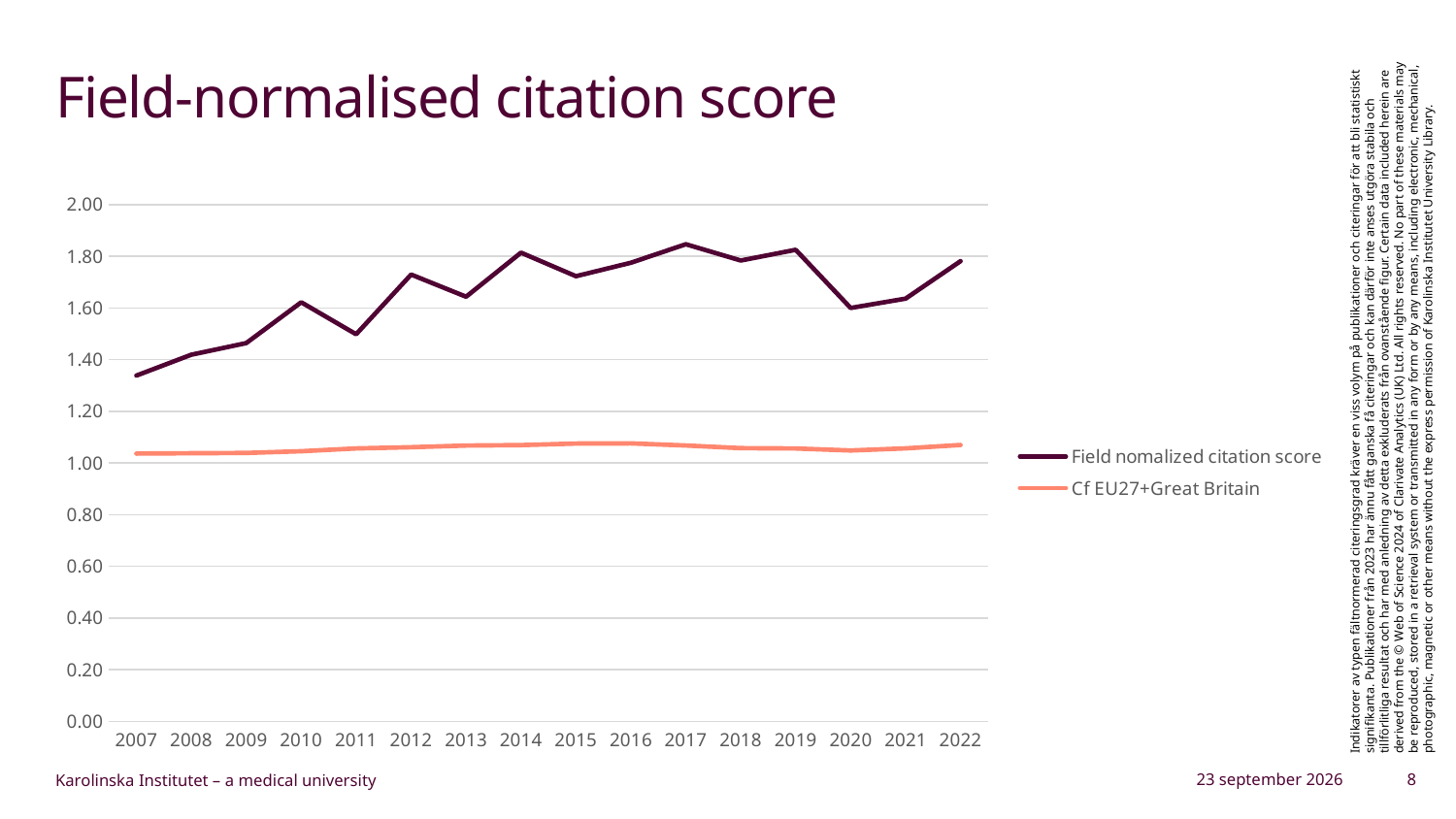
Is the Field nomalized citation score for 2011 greater or less than 1.40? greater Is the Field nomalized citation score for 2007 greater or less than 1.40? less How many series does the legend list? 2 What kind of chart is shown on the slide? Line chart How many years are plotted along the x axis? 16 Is the Cf EU27+Great Britain value for 2015 greater or less than 1.20? less In which year is the Field nomalized citation score lowest? 2007 Which series is drawn in the dark purple line? Field nomalized citation score Does the Field nomalized citation score rise or fall overall from 2007 to 2022? rise Which is larger in 2015: the Field nomalized citation score or the Cf EU27+Great Britain value? Field nomalized citation score What is the title of the chart? Field-normalised citation score